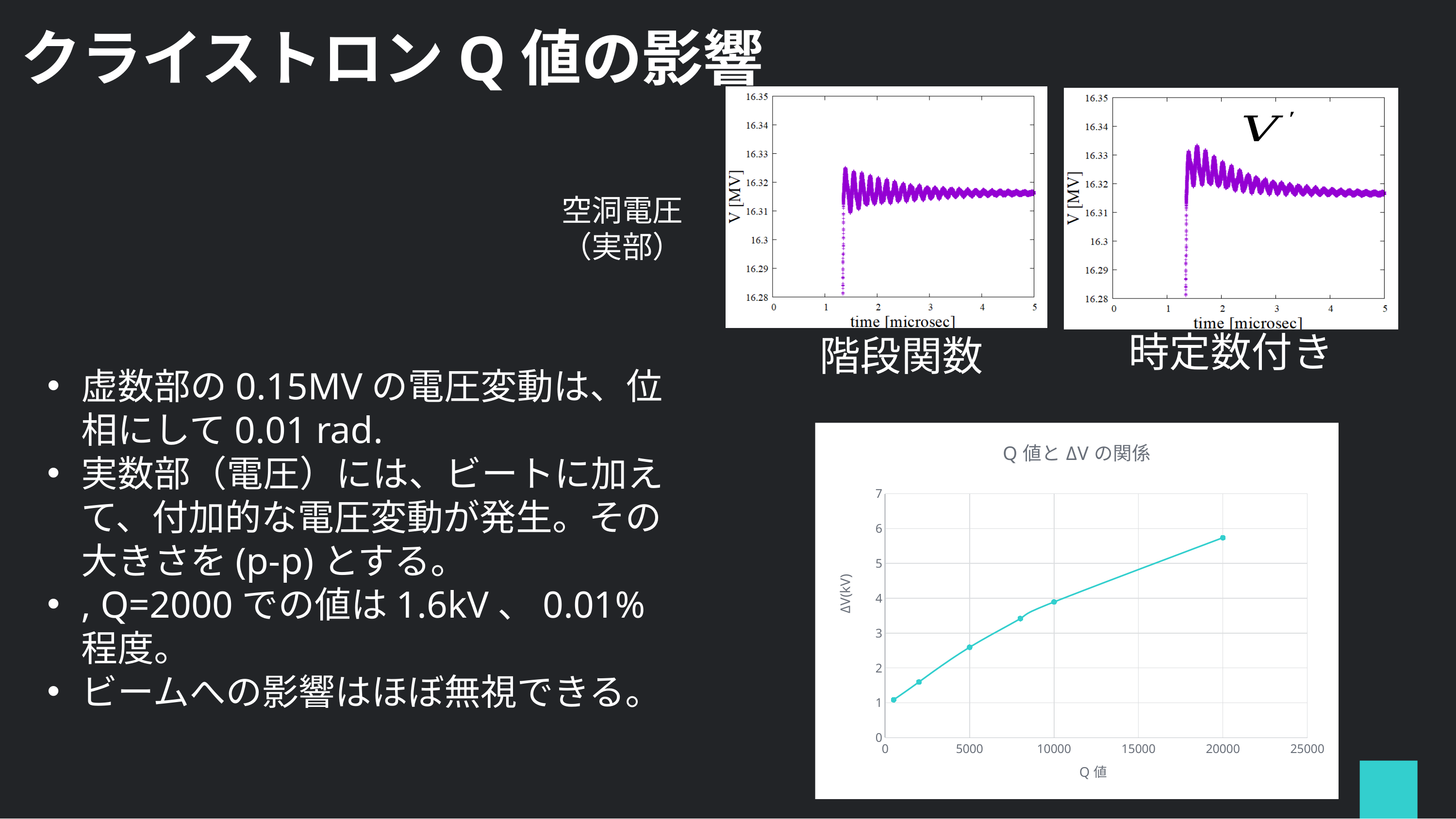
In the chart titled 'Q 値と ΔV の関係', how many data points are plotted? 6 In the chart titled 'Q 値と ΔV の関係', which is larger: ΔV at Q 値 = 5000 or ΔV at Q 値 = 10000? Q 値 = 10000 In the chart titled 'Q 値と ΔV の関係', is the value of ΔV at Q 値 = 5000 greater or less than 3? less In the chart titled 'Q 値と ΔV の関係', what is the label of the y axis? ΔV(kV) In the chart titled 'Q 値と ΔV の関係', does ΔV rise or fall as Q 値 increases? rise In the chart titled 'Q 値と ΔV の関係', at which Q 値 is ΔV highest? 20000 In the chart titled 'Q 値と ΔV の関係', is the value of ΔV at Q 値 = 20000 greater or less than 5? greater In the chart titled 'Q 値と ΔV の関係', is the value of ΔV at Q 値 = 10000 greater or less than 3? greater In the chart titled 'Q 値と ΔV の関係', what kind of chart is shown? line chart In the chart labelled '階段関数' at the top of the slide, what is the label of the x axis? time [microsec] What is the title of the line chart at the bottom right of the slide? Q 値と ΔV の関係